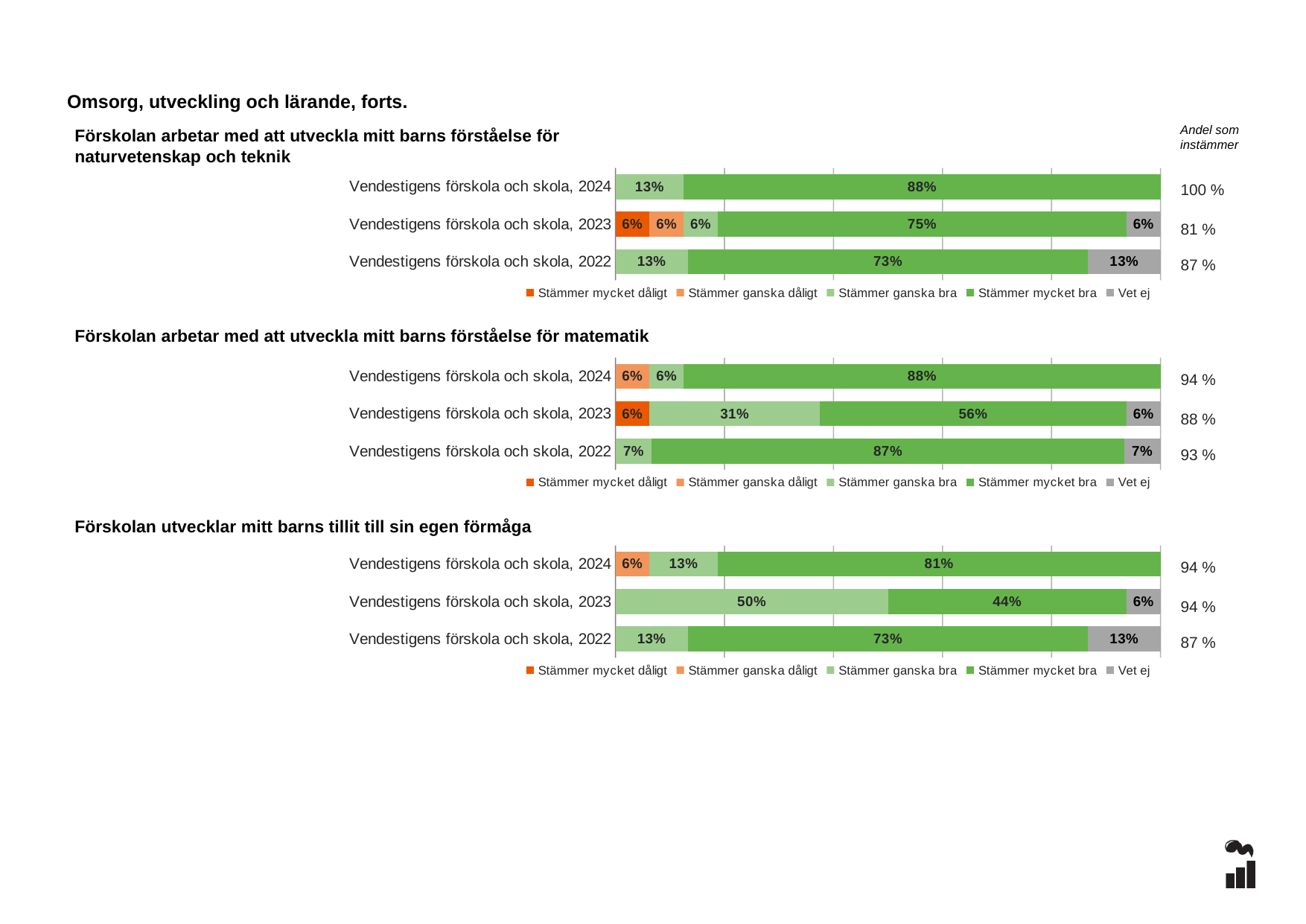
In the chart 'Förskolan utvecklar mitt barns tillit till sin egen förmåga', which is larger for 2023: 'Stämmer ganska bra' or 'Stämmer mycket bra'? Stämmer ganska bra In the chart 'Förskolan arbetar med att utveckla mitt barns förståelse för matematik', which year has the highest 'Stämmer mycket bra' value? 2024 In the chart 'Förskolan arbetar med att utveckla mitt barns förståelse för naturvetenskap och teknik', what is the 'Stämmer mycket bra' value for Vendestigens förskola och skola, 2024? 88% In the chart 'Förskolan arbetar med att utveckla mitt barns förståelse för naturvetenskap och teknik', what is the 'Andel som instämmer' value for Vendestigens förskola och skola, 2023? 81 % In the chart 'Förskolan arbetar med att utveckla mitt barns förståelse för matematik', what is the 'Stämmer ganska bra' value for Vendestigens förskola och skola, 2023? 31% In the chart 'Förskolan utvecklar mitt barns tillit till sin egen förmåga', what is the 'Stämmer ganska bra' value for Vendestigens förskola och skola, 2023? 50% How many series does the legend list for the chart 'Förskolan arbetar med att utveckla mitt barns förståelse för matematik'? 5 What type of chart is used for 'Förskolan utvecklar mitt barns tillit till sin egen förmåga'? Stacked bar chart In the chart 'Förskolan utvecklar mitt barns tillit till sin egen förmåga', which year has the lowest 'Andel som instämmer' value? 2022 How many bars (years) are shown in the chart 'Förskolan arbetar med att utveckla mitt barns förståelse för naturvetenskap och teknik'? 3 In the chart 'Förskolan arbetar med att utveckla mitt barns förståelse för matematik', what is the difference between the 'Stämmer mycket bra' values for 2024 and 2023? 32 percentage points In the chart 'Förskolan arbetar med att utveckla mitt barns förståelse för naturvetenskap och teknik', what is the 'Vet ej' value for Vendestigens förskola och skola, 2022? 13%